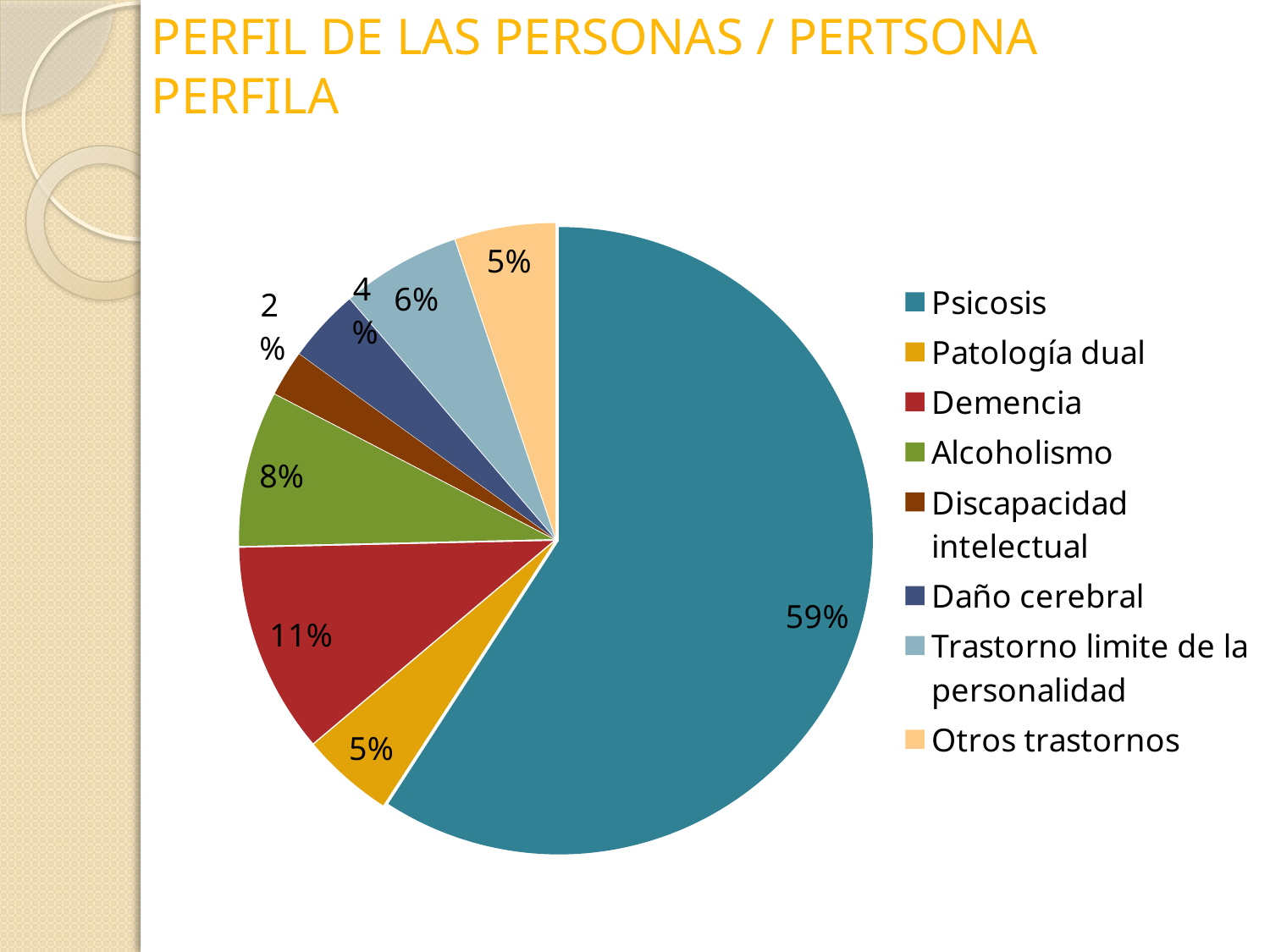
What is the value shown for Demencia? 11% What type of chart is shown on the slide? pie chart What percentage of the pie does Psicosis represent? 59% How many categories does the legend list? 8 What is the value shown for Trastorno limite de la personalidad? 6% Which is larger, the share for Daño cerebral or the share for Trastorno limite de la personalidad? Trastorno limite de la personalidad What is the difference between the shares of Demencia and Alcoholismo? 3% What is the value shown for Alcoholismo? 8% What is the value shown for Discapacidad intelectual? 2% Which category has the smallest share of the pie? Discapacidad intelectual Which category has the largest share of the pie? Psicosis What colour is the slice for Otros trastornos? light orange (peach)